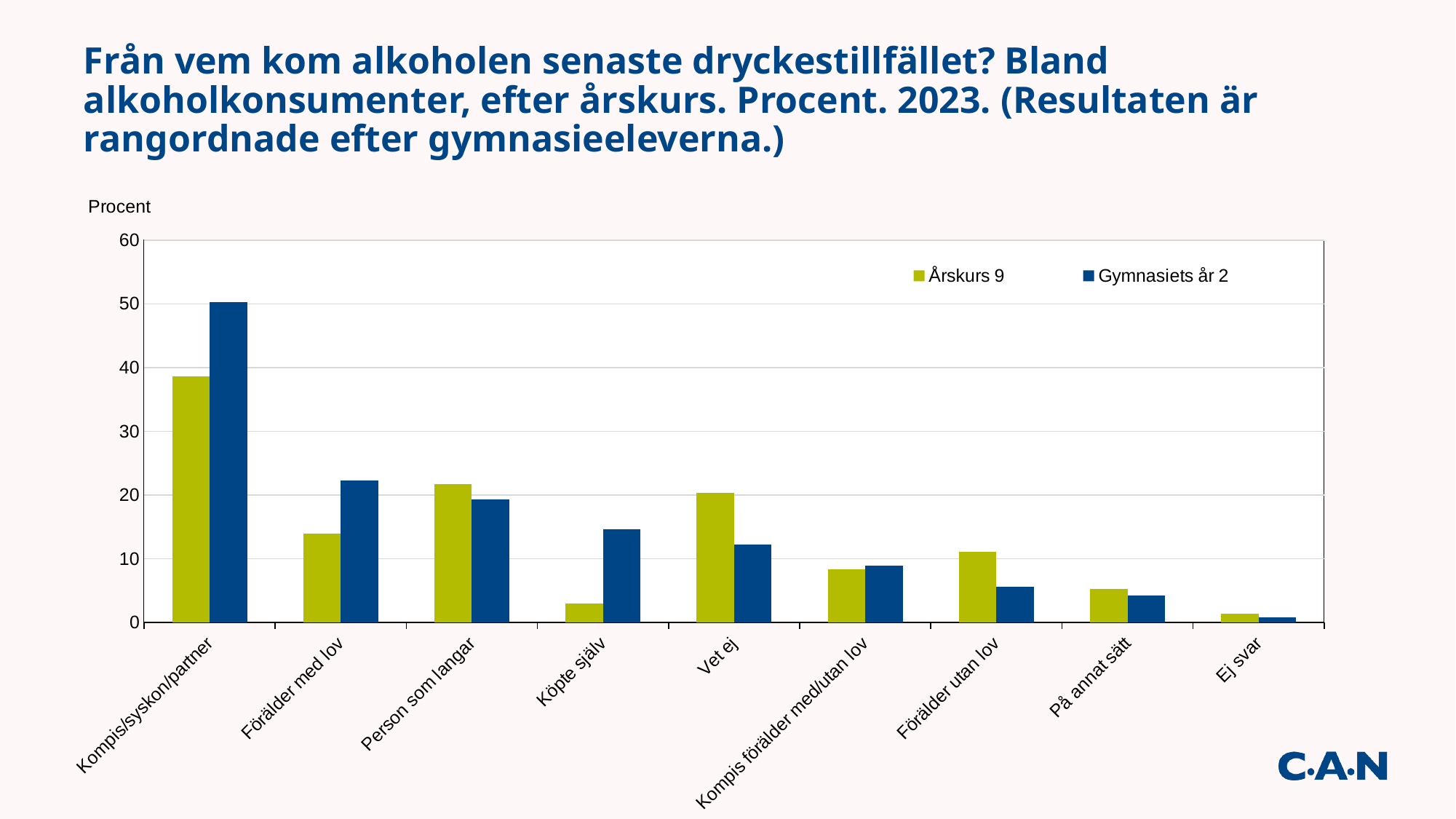
For the category Vet ej, which series has the larger value, Årskurs 9 or Gymnasiets år 2? Årskurs 9 Which category has the highest value for Gymnasiets år 2? Kompis/syskon/partner Which category has the lowest value for Gymnasiets år 2? Ej svar Which category has the highest value for Årskurs 9? Kompis/syskon/partner How many series does the legend list? 2 What are the two series named in the legend? Årskurs 9 and Gymnasiets år 2 What kind of chart is shown on the slide? Bar chart How many categories are shown on the x axis? 9 Is the value for Årskurs 9 in the category Köpte själv greater or less than 10? less Is the value for Gymnasiets år 2 in the category Kompis/syskon/partner greater or less than 40? greater For the category Köpte själv, which series has the larger value, Årskurs 9 or Gymnasiets år 2? Gymnasiets år 2 Do the values for Gymnasiets år 2 rise or fall from left to right along the x axis? fall